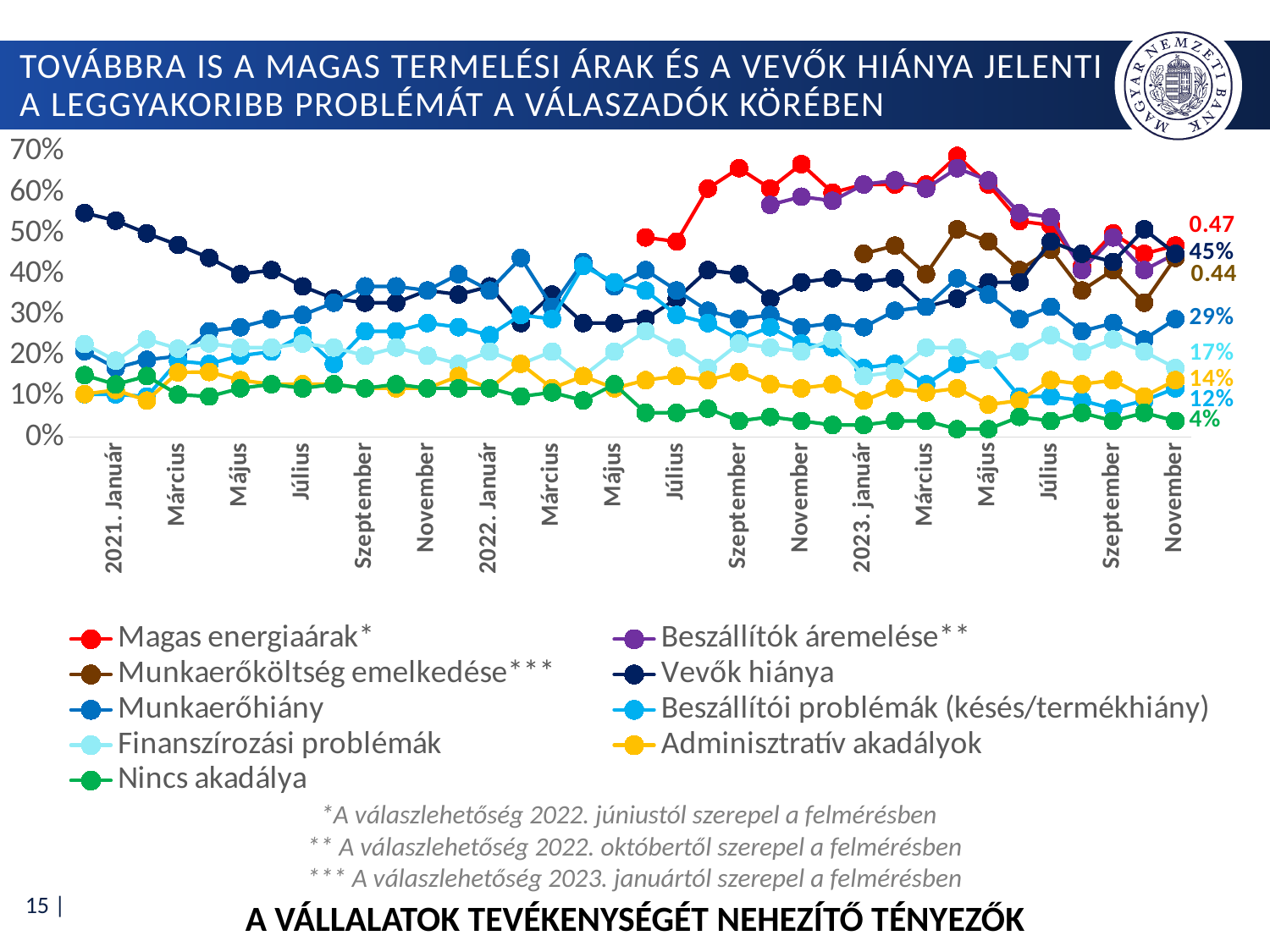
How many series does the legend list? 9 Is the value for Vevők hiánya in 2021. Január greater or less than 50%? greater What is the difference between the final labelled values of Vevők hiánya (45%) and Munkaerőhiány (29%)? 16 percentage points At the end of the period, which is larger: Munkaerőhiány or Finanszírozási problémák? Munkaerőhiány Does the Nincs akadálya series rise or fall from 2021. Január to November 2023? fall What kind of chart is shown on the slide? line chart What is the value labelled at the end of the Munkaerőköltség emelkedése series? 0.44 Which series has the lowest value at the end of the period (November 2023)? Nincs akadálya What is the value labelled at the end of the Magas energiaárak series (November 2023)? 0.47 What is the value labelled at the end of the Munkaerőhiány series? 29% What is the value labelled at the end of the Nincs akadálya series? 4% What is the value labelled at the end of the Vevők hiánya series (November 2023)? 45%